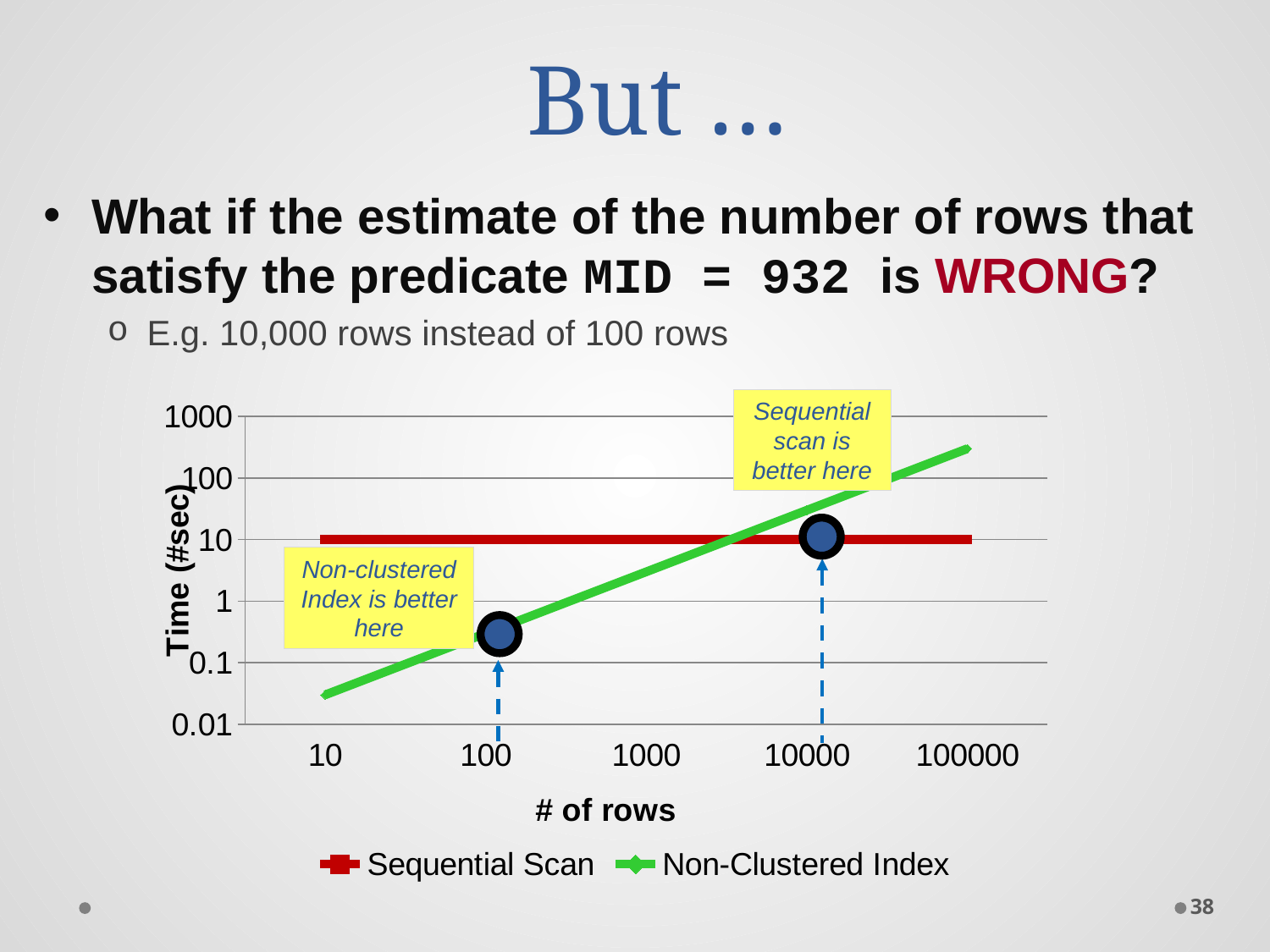
What are the two series named in the chart's legend? Sequential Scan and Non-Clustered Index At 100000 rows, which series has the larger time value, Sequential Scan or Non-Clustered Index? Non-Clustered Index What kind of chart is shown on the slide? line chart What time value does the Sequential Scan line sit at across all row counts? 10 What is the title of the chart's x axis? # of rows Is the Non-Clustered Index value at 100 rows greater or less than 1? less How many series does the chart's legend list? 2 Does the Sequential Scan line rise, fall, or stay flat as the number of rows increases? stays flat At 100 rows, which series has the larger time value, Sequential Scan or Non-Clustered Index? Sequential Scan Does the Non-Clustered Index line rise or fall as the number of rows increases? rises Is the Non-Clustered Index value at 100000 rows greater or less than 100? greater Is the Non-Clustered Index value at 10 rows greater or less than 0.1? less